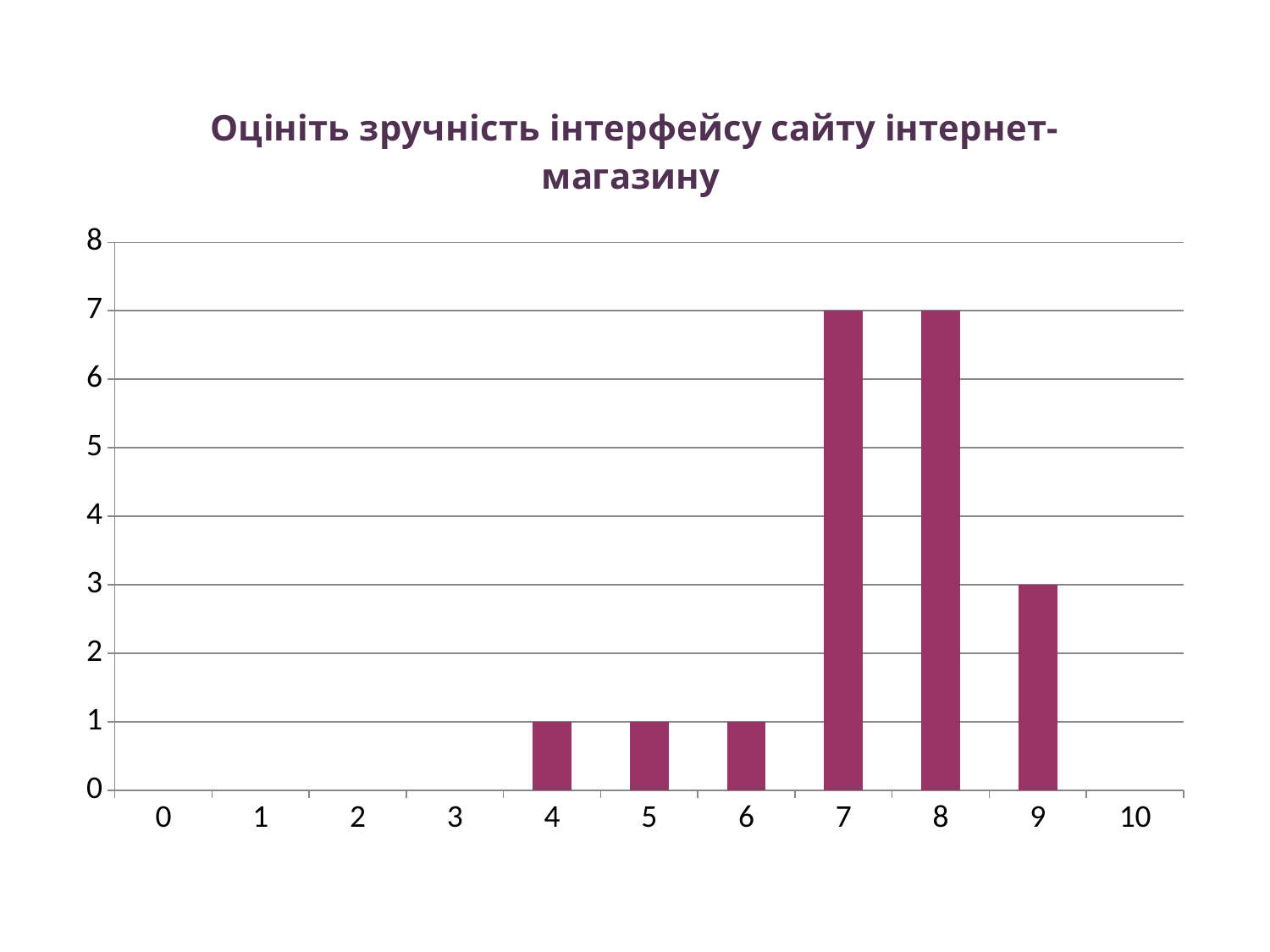
What is the value for category 4? 1 Which has the larger value, category 7 or category 9? 7 What is the value for category 2? 0 What is the difference between the values for category 8 and category 9? 4 What is the value for category 9? 3 What is the value for category 8? 7 What is the title of the chart? Оцініть зручність інтерфейсу сайту інтернет-магазину What is the value for category 7? 7 How many categories are shown on the x axis? 11 Is the value for category 9 greater or less than 2? greater What kind of chart is shown on the slide? bar chart Which has the larger value, category 6 or category 9? 9